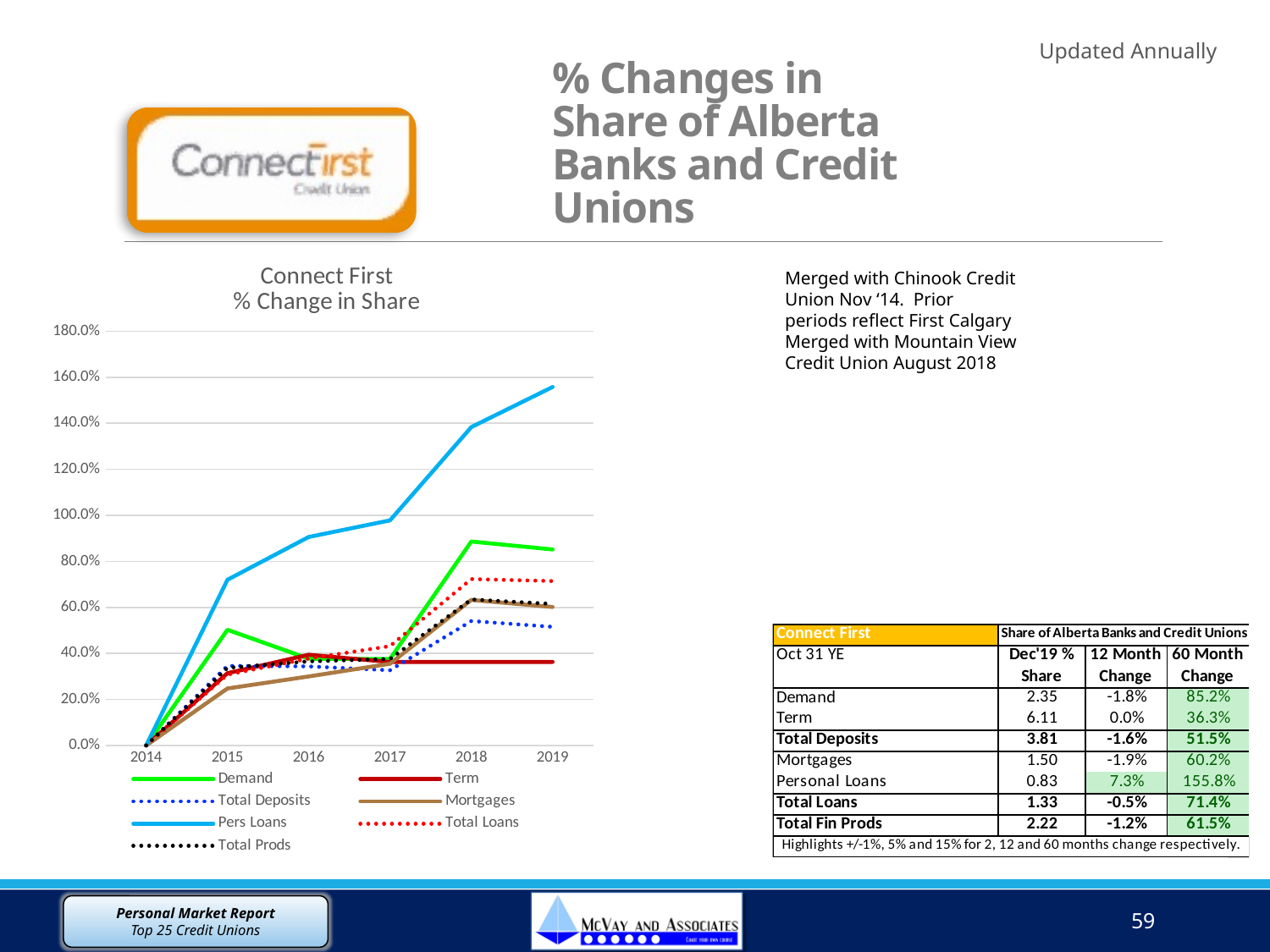
Is the value for Term in 2019 greater or less than 40%? less What is the title of the chart? Connect First % Change in Share How many series does the legend of the chart list? 7 Which series has the lowest value in 2019? Term Is the value for Pers Loans in 2016 greater or less than 80%? greater In 2018, which is larger, the value for Demand or the value for Term? Demand Is the value for Demand in 2019 greater or less than 100%? less How many years are plotted along the x axis of the chart? 6 Does the Pers Loans series rise or fall from 2014 to 2019? rise What kind of chart is shown on the slide? line chart Which series has the highest value in 2019? Pers Loans